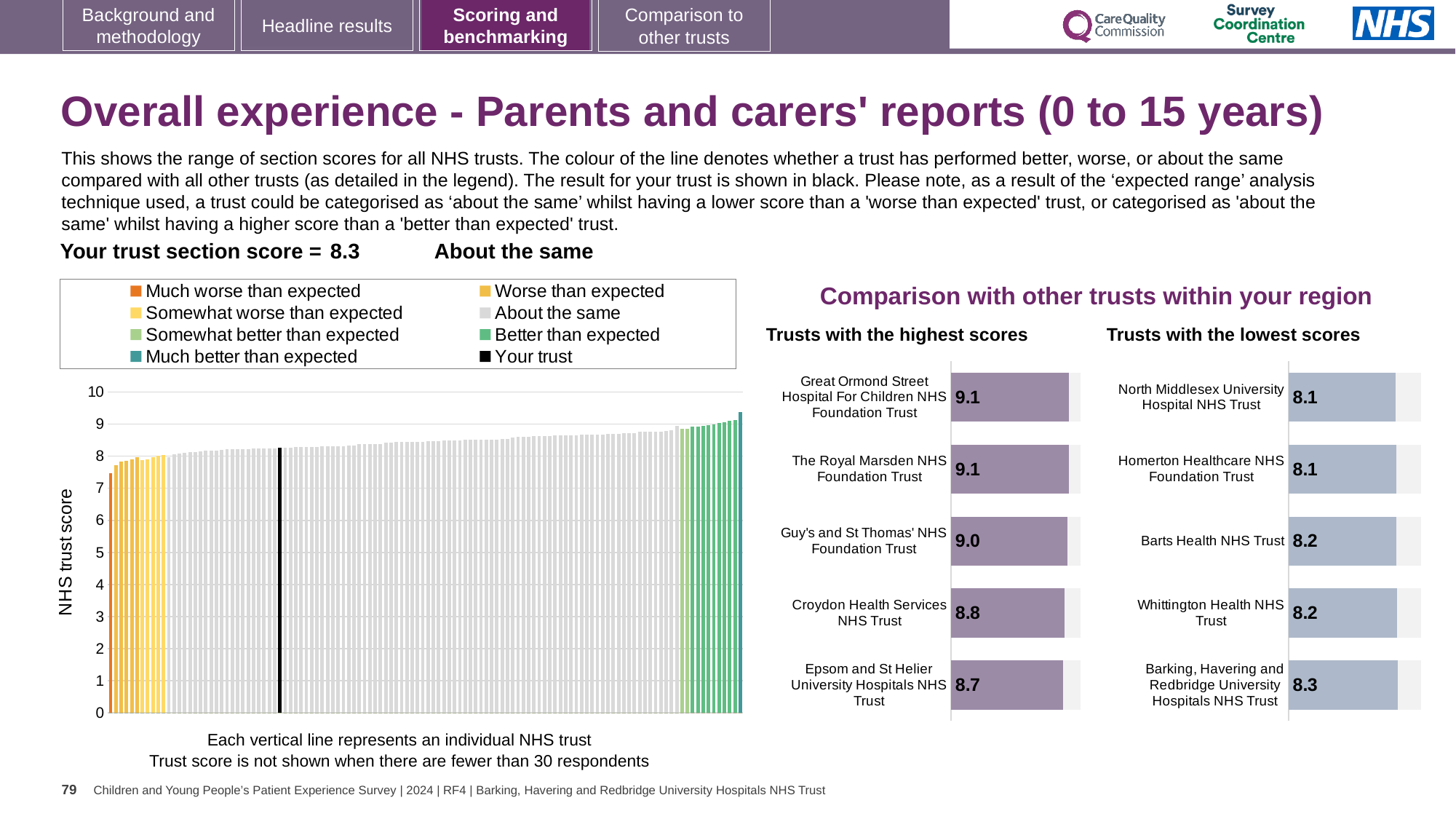
In the 'Trusts with the highest scores' chart, which trust has the lowest score? Epsom and St Helier University Hospitals NHS Trust In the main chart on the left, is the value of the lowest (orange) bar greater or less than 8? less How many trusts are shown in the 'Trusts with the lowest scores' chart? 5 In the 'Trusts with the highest scores' chart, what is the score for Croydon Health Services NHS Trust? 8.8 In the 'Trusts with the highest scores' chart, what is the score for Great Ormond Street Hospital For Children NHS Foundation Trust? 9.1 In the 'Trusts with the lowest scores' chart, what is the difference between the scores of Barking, Havering and Redbridge University Hospitals NHS Trust and Homerton Healthcare NHS Foundation Trust? 0.2 In the 'Trusts with the lowest scores' chart, which trust has the highest score? Barking, Havering and Redbridge University Hospitals NHS Trust In the 'Trusts with the highest scores' chart, which has the larger score: Guy's and St Thomas' NHS Foundation Trust or Croydon Health Services NHS Trust? Guy's and St Thomas' NHS Foundation Trust In the 'Trusts with the highest scores' chart, what is the difference between the scores of The Royal Marsden NHS Foundation Trust and Epsom and St Helier University Hospitals NHS Trust? 0.4 How many entries does the legend of the main chart on the left list? 8 In the 'Trusts with the lowest scores' chart, what is the score for Barts Health NHS Trust? 8.2 In the main chart on the left showing the range of section scores, what is the section score for your trust (the black bar)? 8.3